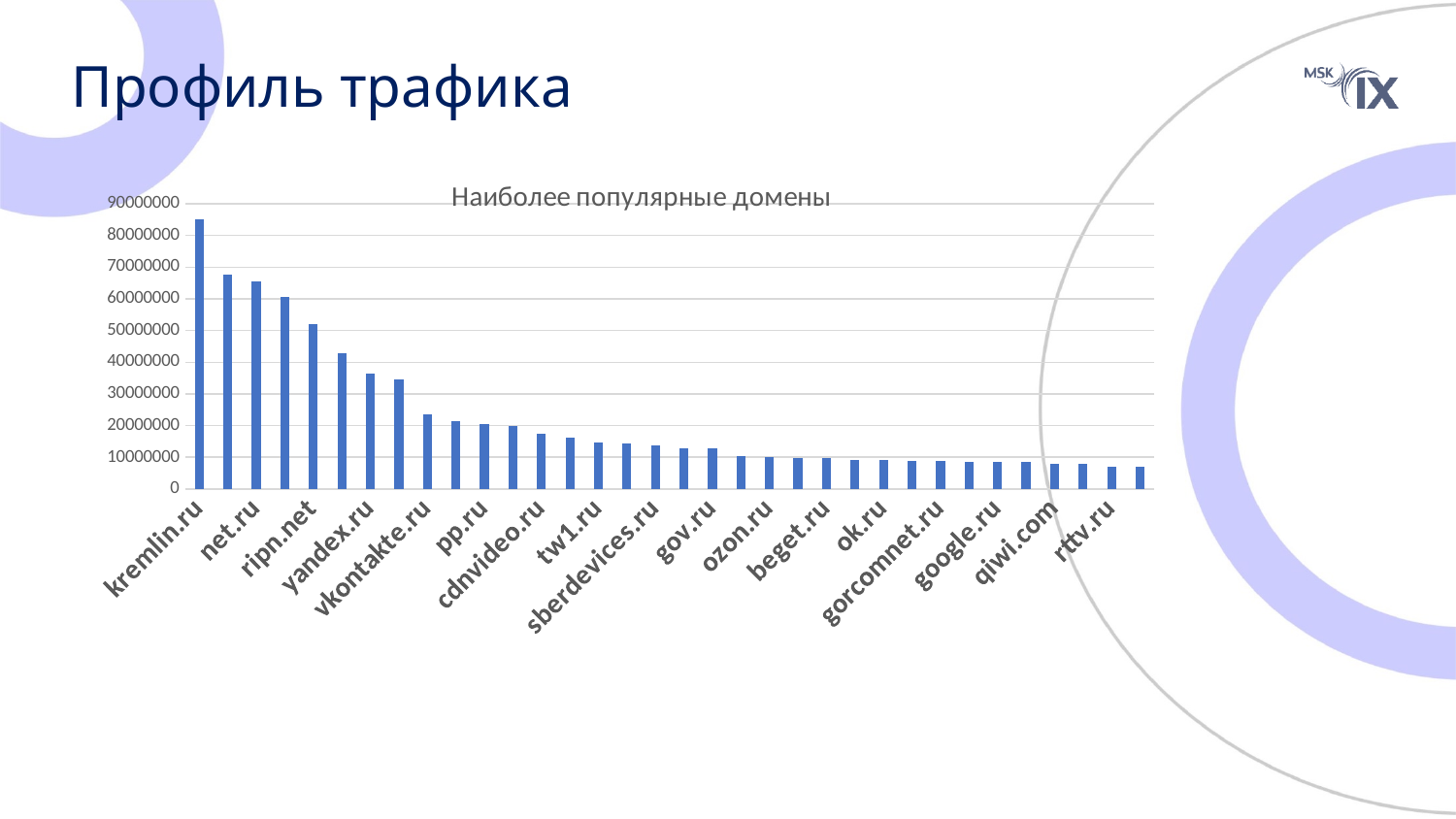
Is the value for ripn.net greater or less than 50000000? greater Is the value for rttv.ru greater or less than 10000000? less Which has a larger value, kremlin.ru or net.ru? kremlin.ru Do the values rise or fall moving from left to right along the x axis? fall What is the title of the chart? Наиболее популярные домены Is the value for yandex.ru greater or less than 40000000? less Which has a larger value, yandex.ru or vkontakte.ru? yandex.ru What kind of chart is shown on the slide? bar chart Which domain has the highest value in the chart? kremlin.ru